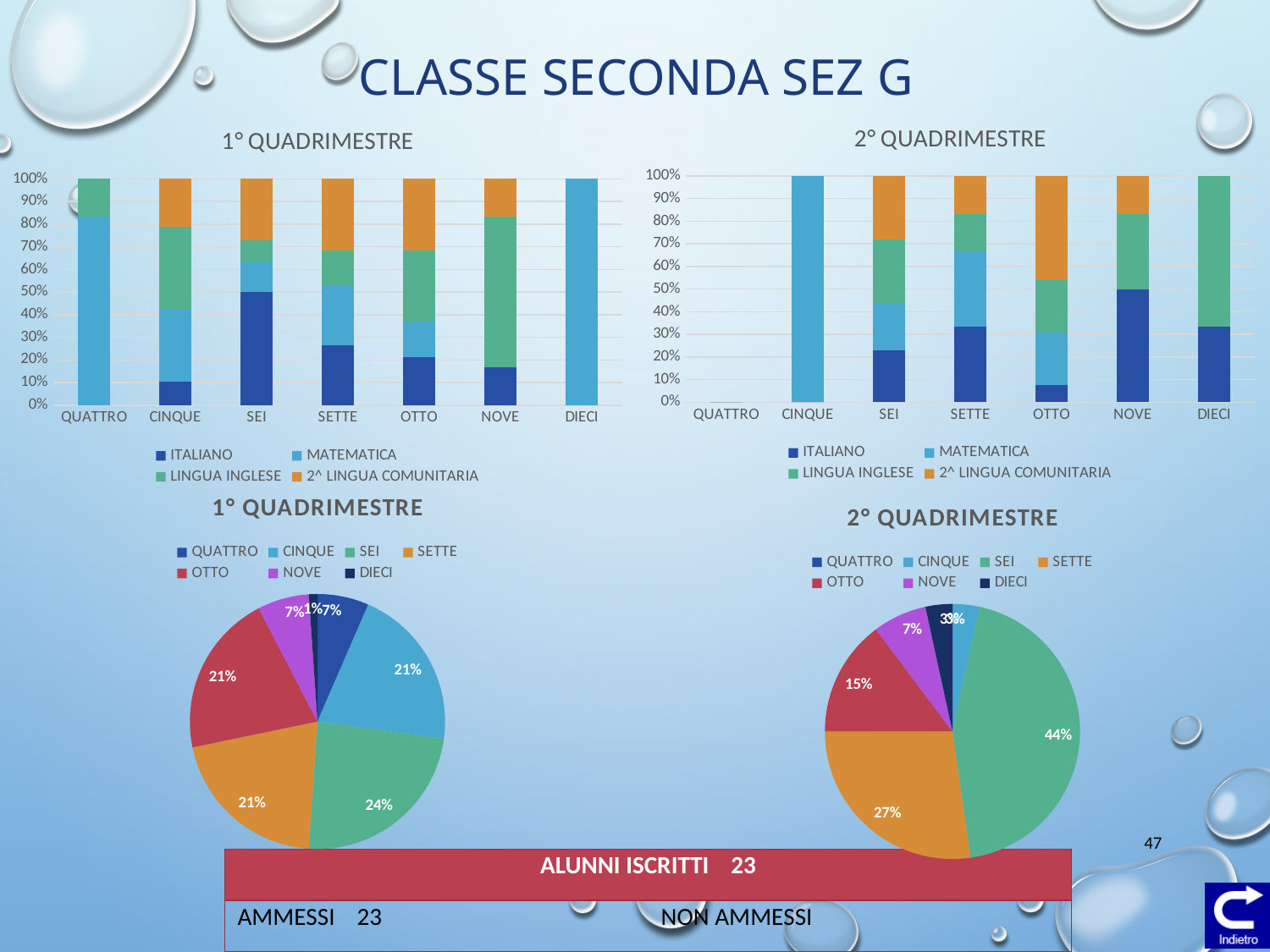
In the 1° QUADRIMESTRE pie chart, which category has the largest share? SEI In the 1° QUADRIMESTRE pie chart, which category has the smallest share? DIECI How many series does the legend of the 1° QUADRIMESTRE stacked bar chart (top left) list? 4 In the 2° QUADRIMESTRE pie chart, which is larger, the share of OTTO or the share of NOVE? OTTO In the 2° QUADRIMESTRE pie chart, what share does SETTE have? 27% In the 1° QUADRIMESTRE pie chart, what share does SEI have? 24% How many categories are shown on the x axis of the 2° QUADRIMESTRE stacked bar chart (top right)? 7 In the 1° QUADRIMESTRE pie chart, what share does CINQUE have? 21% What kind of chart is the 1° QUADRIMESTRE chart at the top left of the slide? Stacked bar chart In the 1° QUADRIMESTRE stacked bar chart (top left), is the ITALIANO value for SETTE greater or less than 20%? greater In the 2° QUADRIMESTRE pie chart, what share does SEI have? 44% In the 2° QUADRIMESTRE pie chart, what is the difference between the shares of SEI and OTTO? 29%